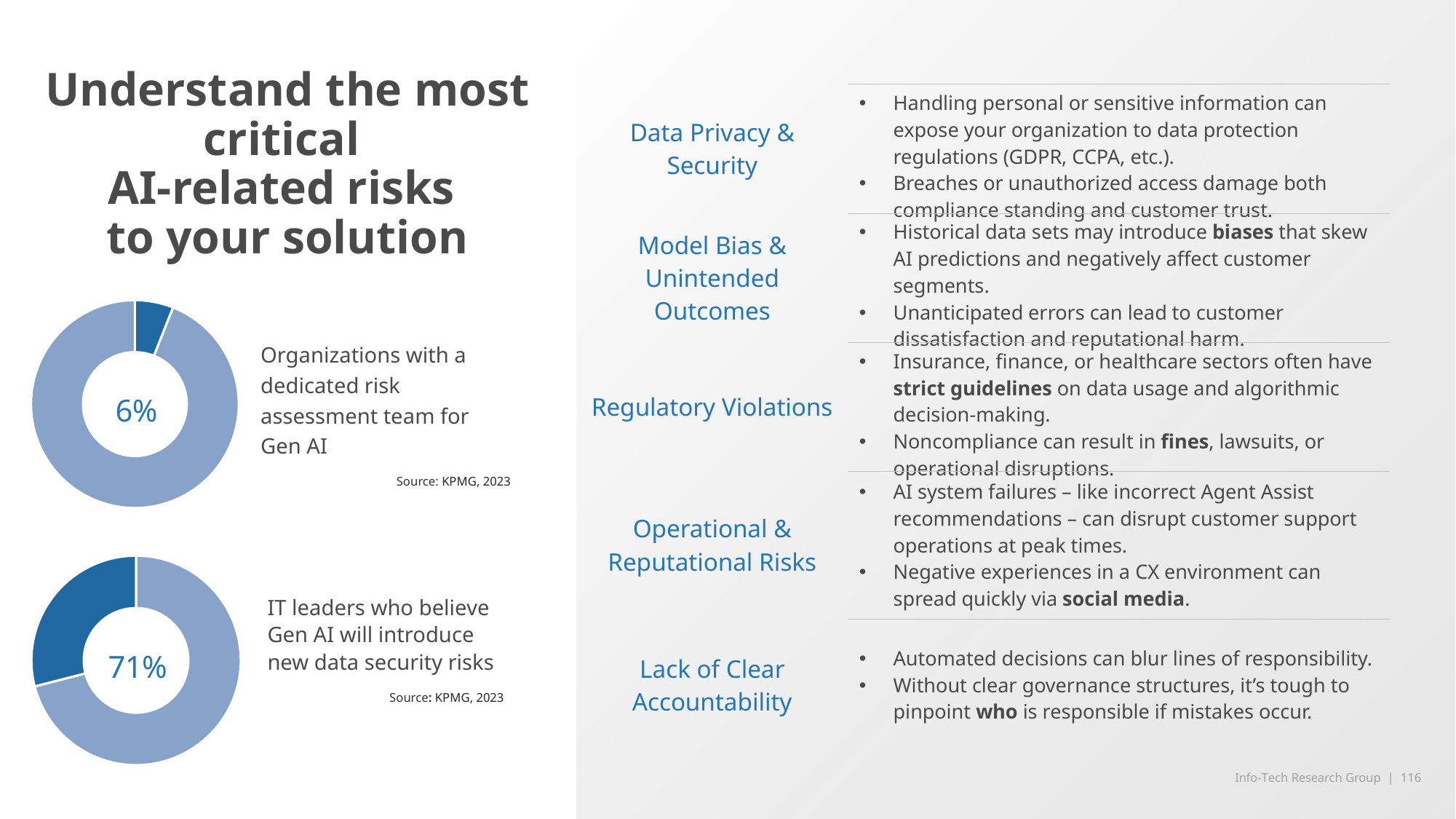
What is the difference in percentage points between the value in the bottom donut chart (71%) and the value in the top donut chart (6%)? 65 percentage points In the top donut chart, what percentage of organizations have a dedicated risk assessment team for Gen AI? 6% What source is cited for the data in both donut charts? KPMG, 2023 In the bottom donut chart, what percentage of IT leaders believe Gen AI will introduce new data security risks? 71% What kind of chart is used on the left side of the slide to show the 6% and 71% figures? Donut (pie) chart What share of the top donut chart is taken by the highlighted dark blue segment? 6% How many segments does each donut chart on the slide have? 2 What does the bottom donut chart (71%) represent? IT leaders who believe Gen AI will introduce new data security risks Which is larger: the percentage in the top donut chart (organizations with a dedicated risk assessment team) or the percentage in the bottom donut chart (IT leaders expecting new data security risks)? The bottom chart (71%) How many donut charts are shown on the slide? 2